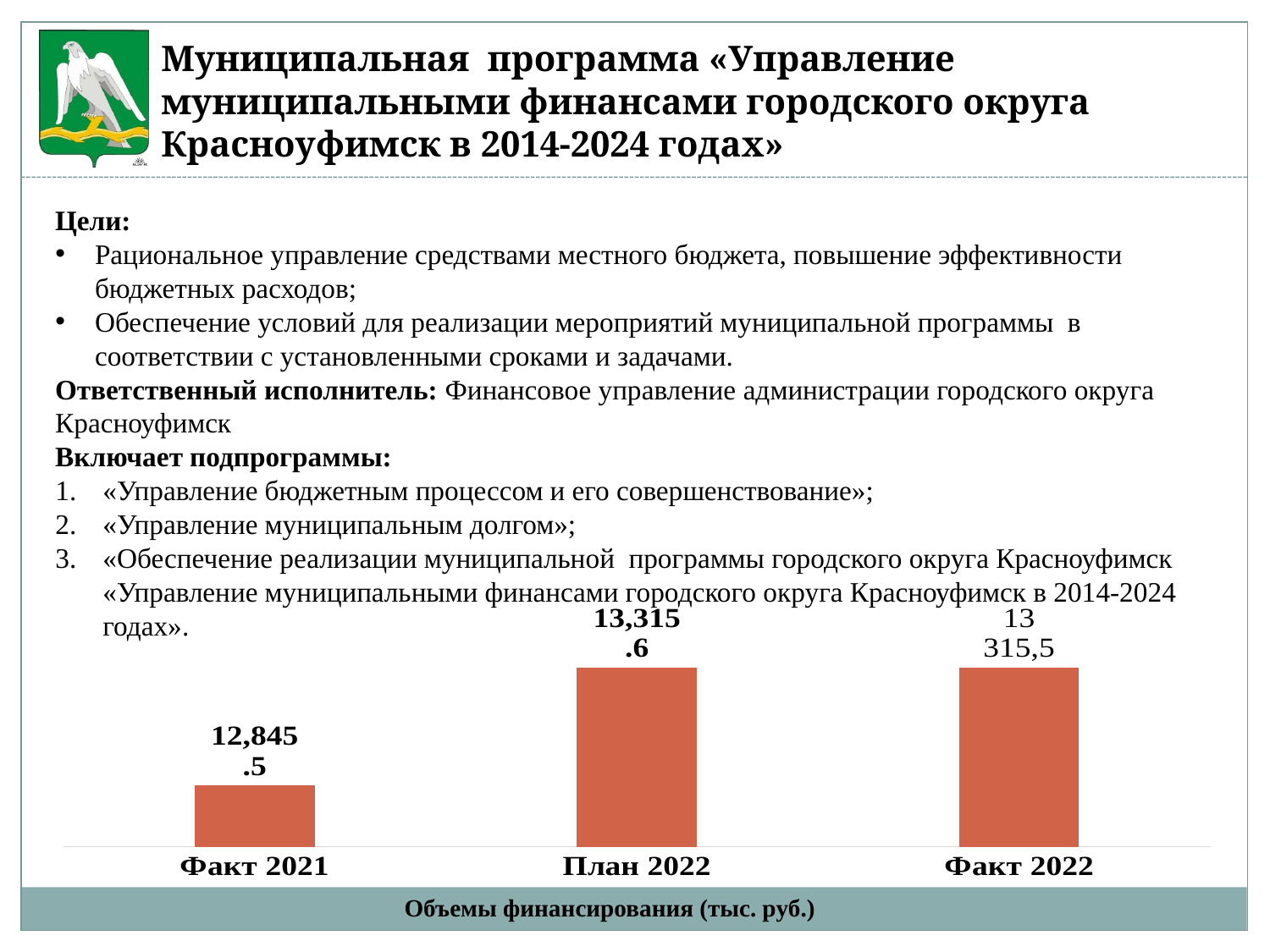
What kind of chart is shown on the slide? Bar chart How many categories are shown in the chart? 3 What is the title of the chart? Объемы финансирования (тыс. руб.) What is the difference between the values for План 2022 and Факт 2021? 470.1 What unit is stated in the chart title? тыс. руб. Which category has the lowest value in the chart? Факт 2021 What is the value for План 2022 in the chart? 13,315.6 Does the value rise or fall from Факт 2021 to План 2022? Rise Which is larger, the value for Факт 2021 or the value for План 2022? План 2022 What is the value shown for Факт 2022 in the chart? 13 315,5 What is the value for Факт 2021 in the chart? 12,845.5 Which is larger, the value for Факт 2021 or the value for Факт 2022? Факт 2022